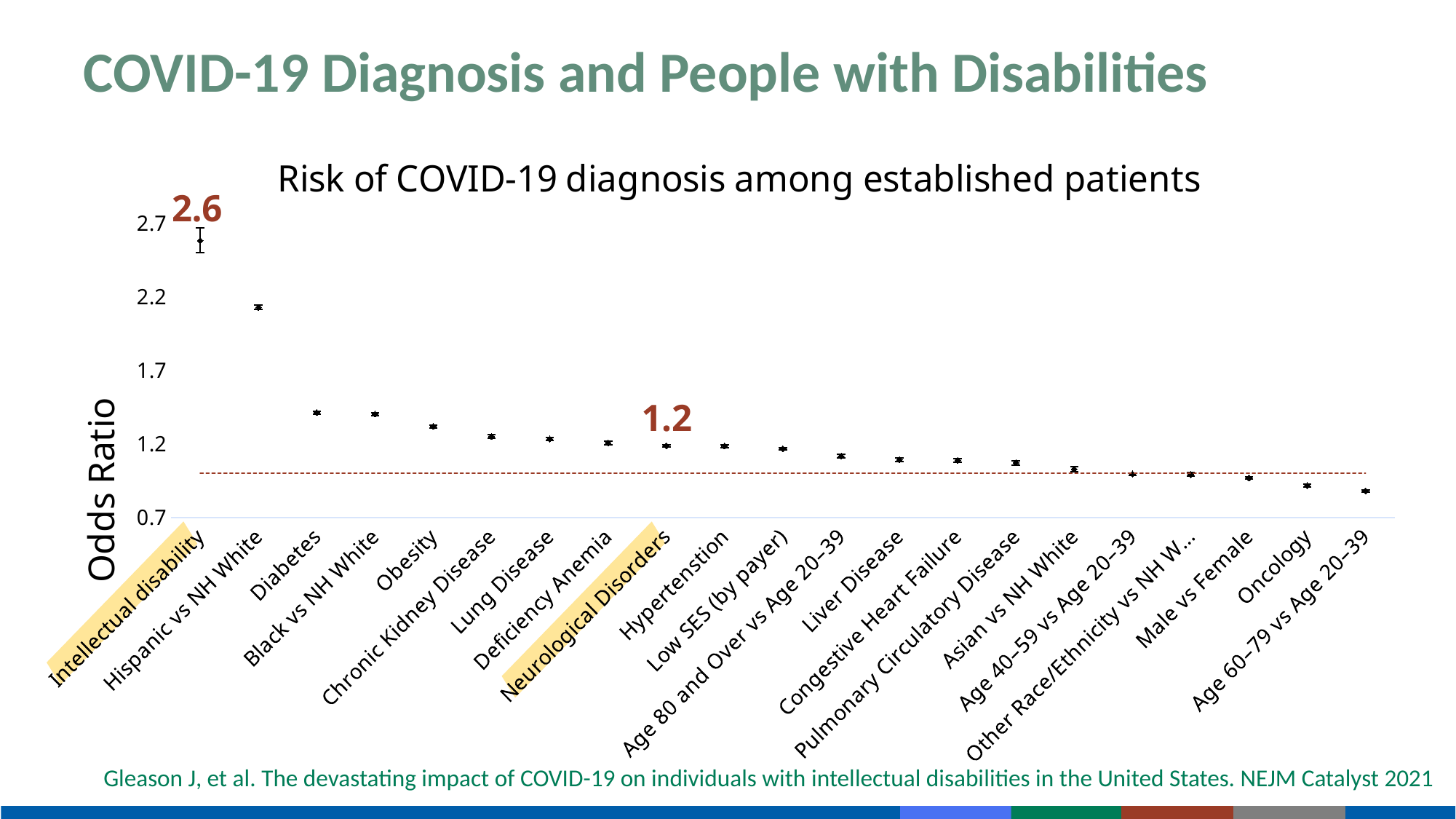
What is the difference between the odds ratio for Intellectual disability and the odds ratio for Neurological Disorders? 1.4 What is the odds ratio shown for Neurological Disorders? 1.2 Is the odds ratio for Oncology greater or less than 1.2? less What is the label on the y axis? Odds Ratio How many categories are plotted on the x axis? 21 What kind of chart is this? Scatter (dot) plot with error bars Is the odds ratio for Hispanic vs NH White greater or less than 1.7? greater What is the odds ratio shown for Intellectual disability? 2.6 Which category has the highest odds ratio? Intellectual disability Which category has the lowest odds ratio? Age 60–79 vs Age 20–39 Which has a higher odds ratio, Hispanic vs NH White or Diabetes? Hispanic vs NH White Do the odds ratios rise or fall moving from left to right along the x axis? Fall